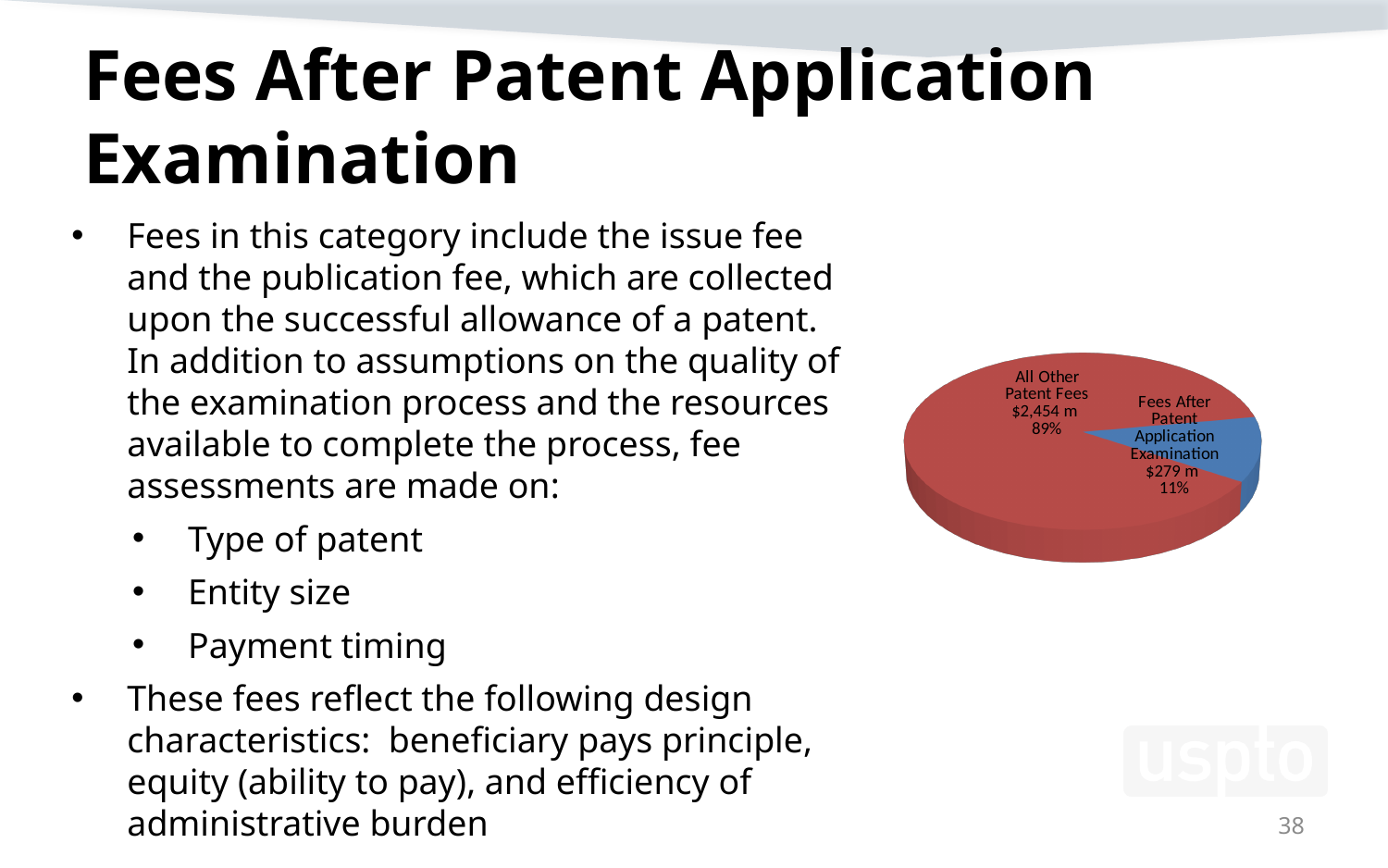
How many slices does the pie chart have? 2 What colour is the Fees After Patent Application Examination slice? Blue What is the difference in dollars between All Other Patent Fees and Fees After Patent Application Examination? $2,175 m Which slice is the largest? All Other Patent Fees What share of the pie is All Other Patent Fees? 89% Which is larger, All Other Patent Fees or Fees After Patent Application Examination? All Other Patent Fees What share of the pie is Fees After Patent Application Examination? 11% What is the total of the two slices in the pie chart? $2,733 m Which slice is the smallest? Fees After Patent Application Examination What kind of chart is shown on the slide? Pie chart What is the value shown for Fees After Patent Application Examination? $279 m What is the value shown for All Other Patent Fees? $2,454 m